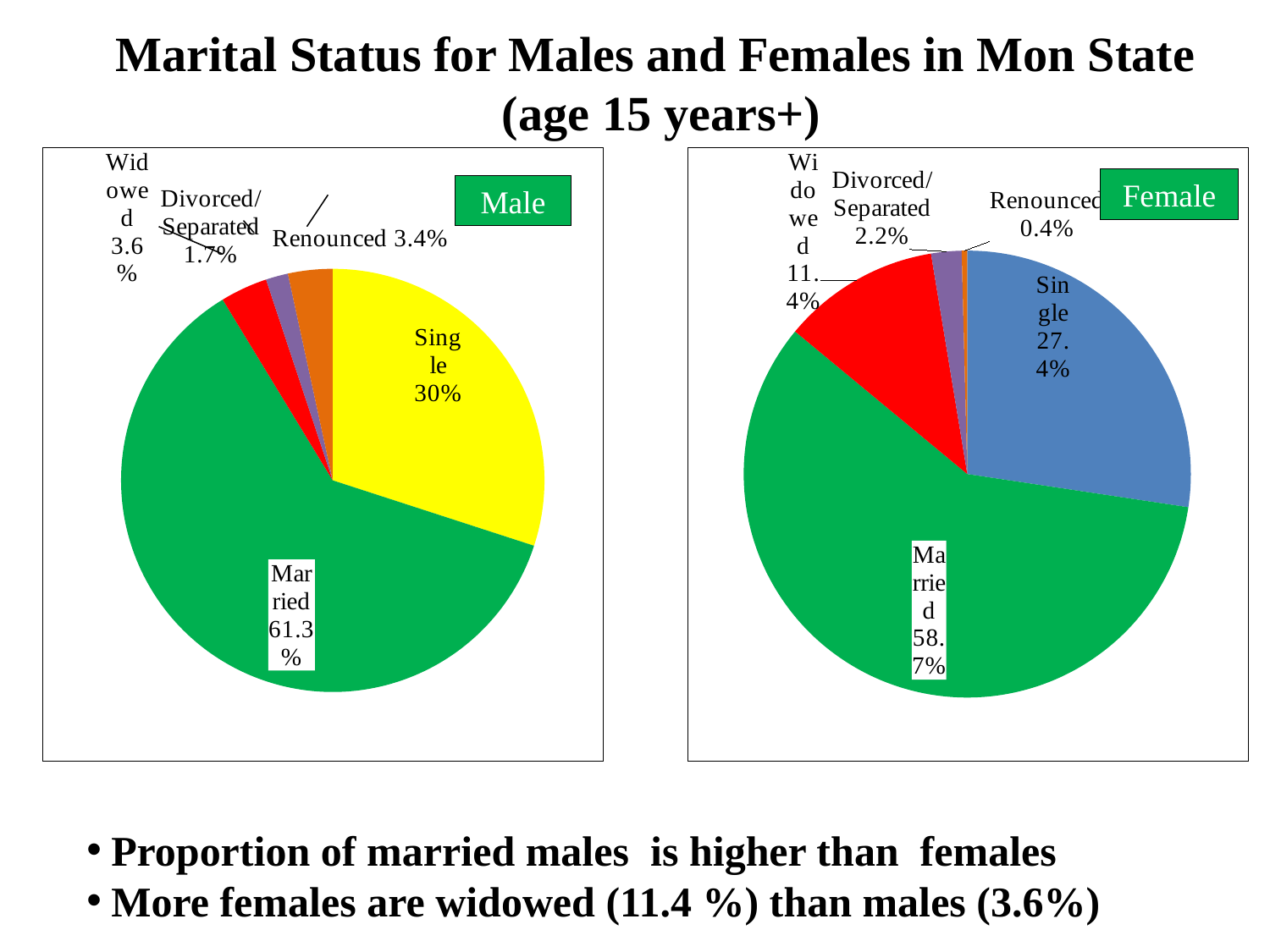
What is the difference between the Married share in the Male chart and the Married share in the Female chart? 2.6% What type of chart is used for the Male data? Pie chart In the Female pie chart, what percentage is Widowed? 11.4% In the Male pie chart, what percentage is Married? 61.3% In the Female pie chart, which category has the smallest share? Renounced In the Male pie chart, what percentage is Renounced? 3.4% In the Male pie chart, which category has the largest share? Married Which is larger: the Widowed share in the Female chart or the Widowed share in the Male chart? Female How many categories does the Female pie chart show? 5 What is the difference between the Single share in the Male chart and the Single share in the Female chart? 2.6% In the Male pie chart, which category has the smallest share? Divorced/Separated In the Female pie chart, what percentage is Single? 27.4%